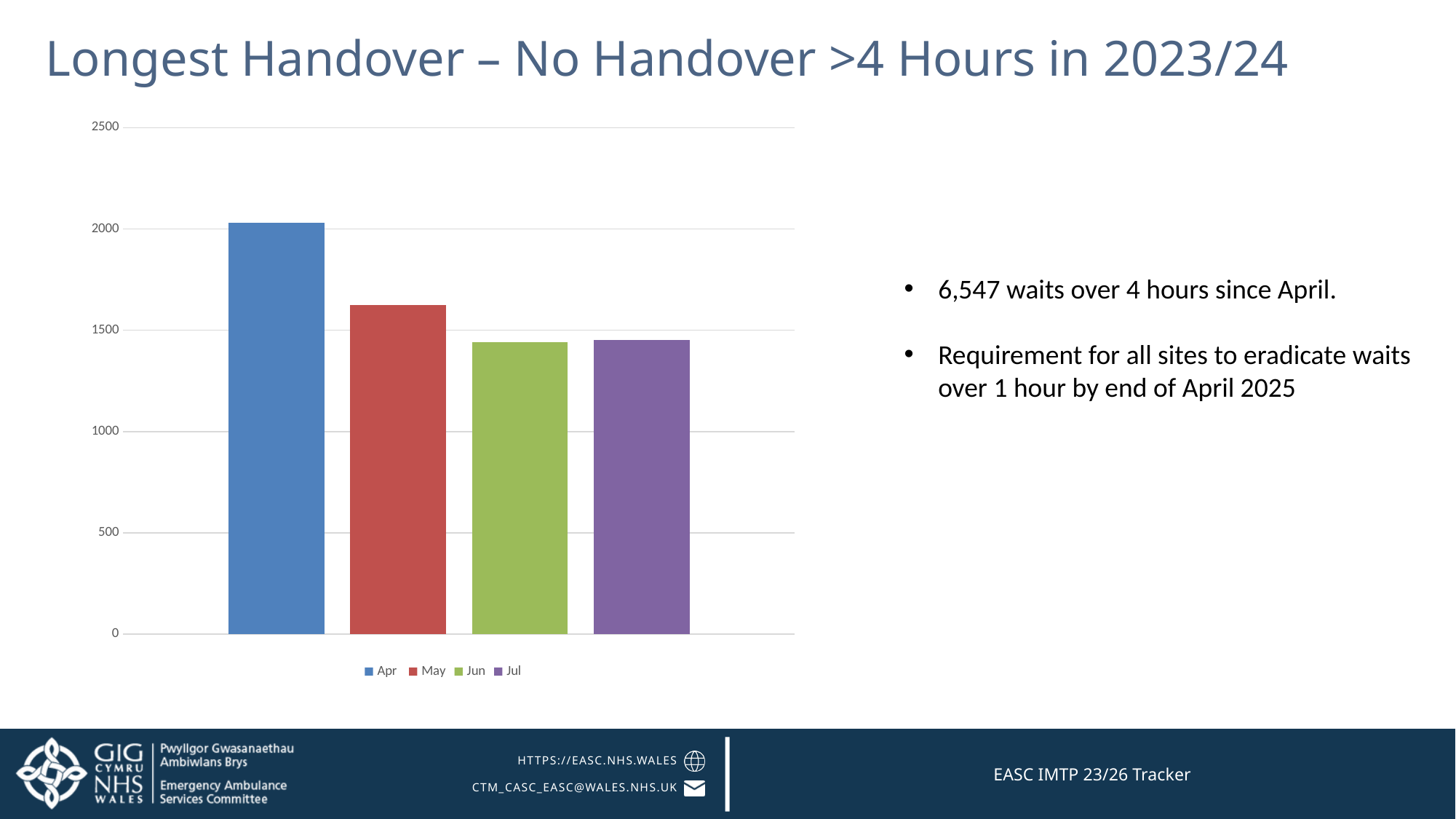
How many entries does the chart legend list? 4 Is the value for May greater or less than 1500? greater What kind of chart is shown on the slide? bar chart Which month has the highest bar in the chart? Apr Which is larger, the value for Apr or the value for May? Apr Is the value for May greater or less than 2000? less Is the value for Apr greater or less than 1500? greater How many bars are plotted in the chart? 4 Which is larger, the value for May or the value for Jun? May Do the values generally rise or fall from Apr to Jul? fall Which is larger, the value for May or the value for Jul? May